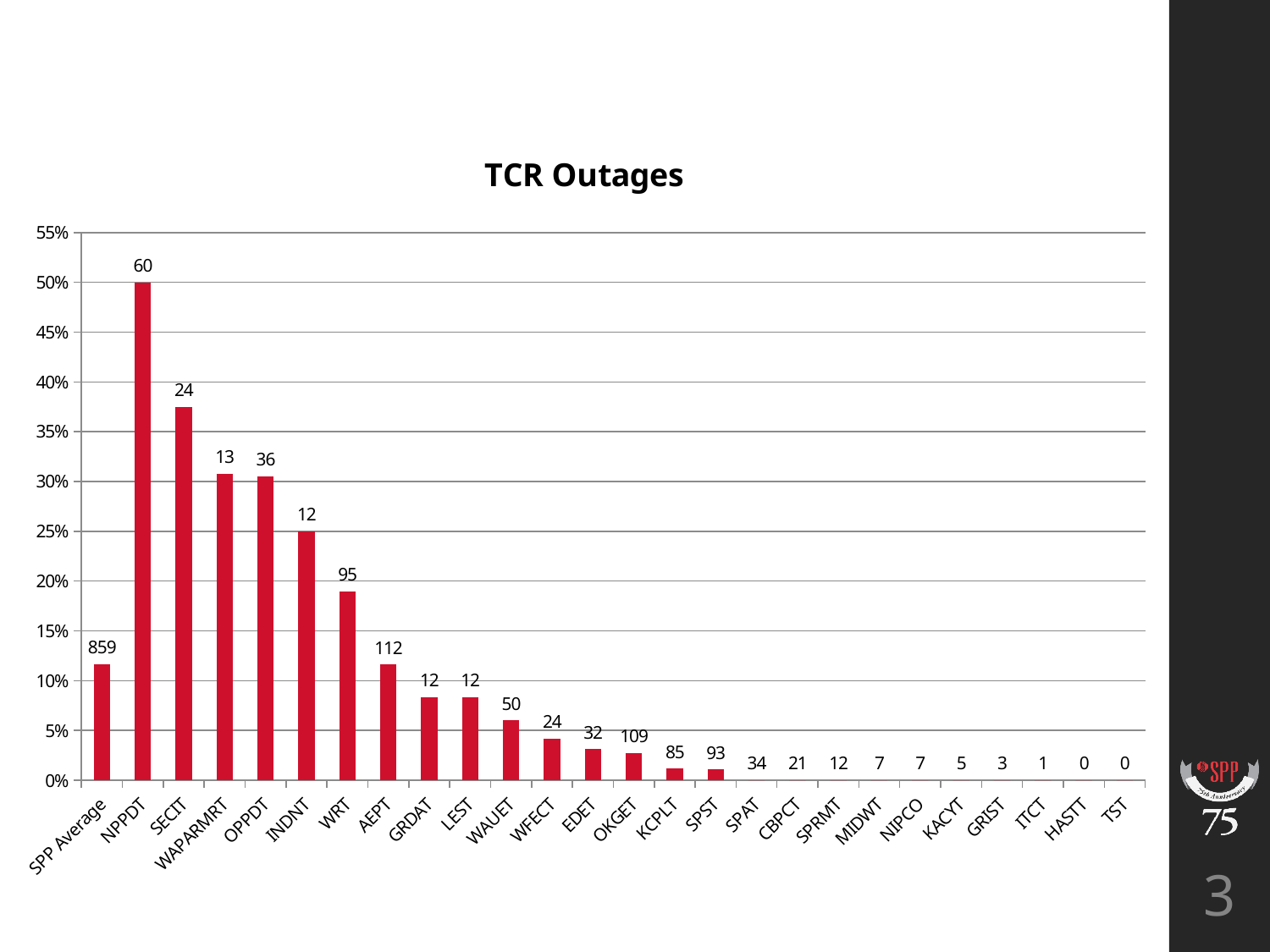
What percentage does the NPPDT bar reach on the y axis? 50% What number is printed above the SPP Average bar? 859 Which bar is taller, SECIT or WAPARMRT? SECIT What kind of chart is shown on the slide? bar chart Is the value for SECIT greater or less than 35%? greater What number is printed above the AEPT bar? 112 What number is printed above the OKGET bar? 109 What percentage does the INDNT bar reach on the y axis? 25% What is the title of the chart? TCR Outages Which category has the tallest bar in the TCR Outages chart? NPPDT Is the value for WRT greater or less than 20%? less How many categories are shown on the x axis of the chart? 26